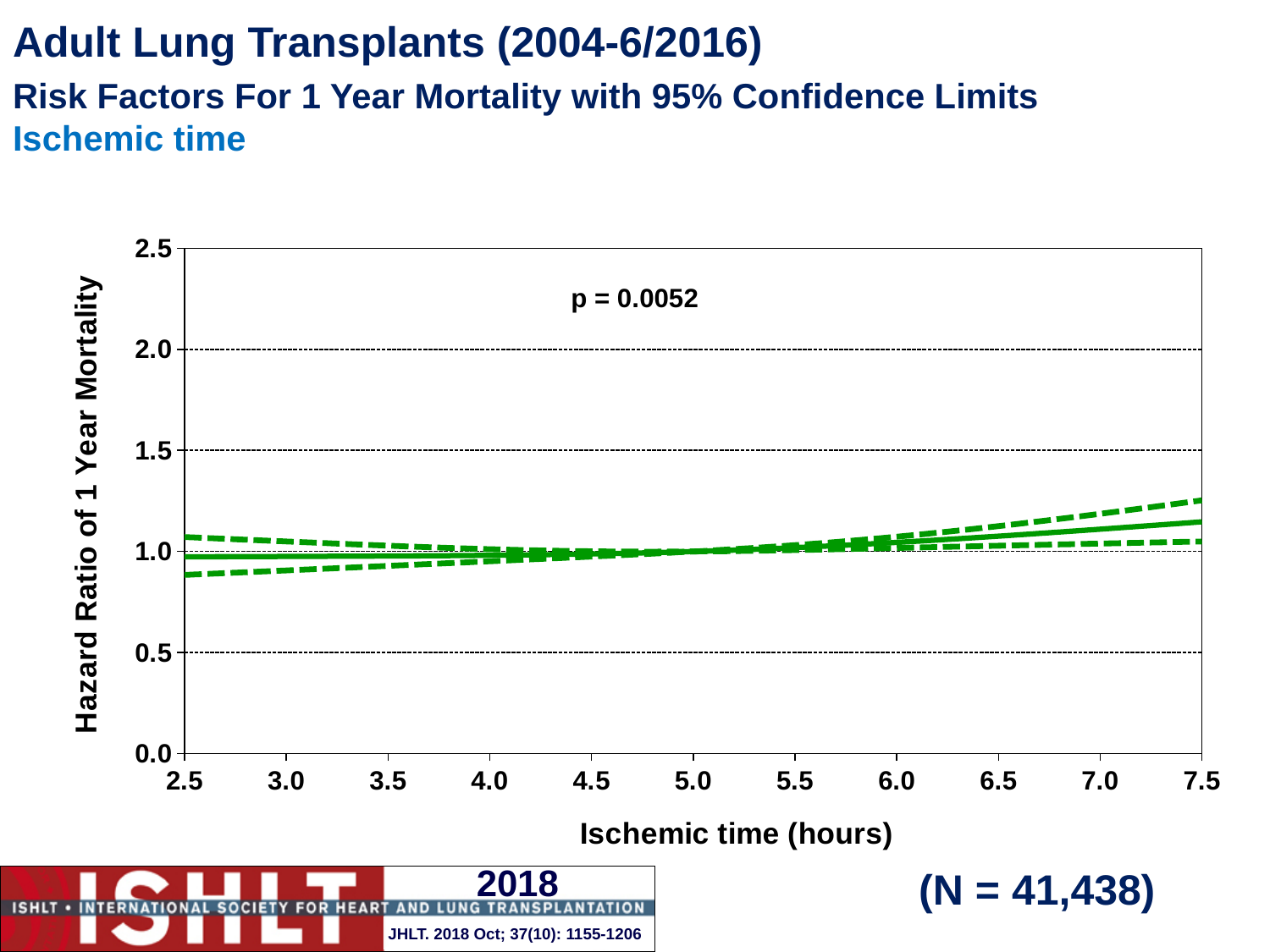
At which ischemic time shown on the x axis is the hazard ratio of 1 year mortality highest? 7.5 hours Is the hazard ratio of 1 year mortality at an ischemic time of 7.5 hours greater or less than 1.0? greater How many lines are plotted on the chart (the estimate plus its confidence limits)? 3 What kind of chart is shown on the slide? line chart Does the hazard ratio of 1 year mortality rise or fall as ischemic time increases from 5.0 to 7.5 hours? rise Is the lower 95% confidence limit at an ischemic time of 2.5 hours greater or less than 0.5? greater Is the hazard ratio at an ischemic time of 7.5 hours larger or smaller than the hazard ratio at 5.0 hours? larger Is the upper 95% confidence limit at an ischemic time of 7.5 hours greater or less than 1.5? less What p-value is printed on the chart? p = 0.0052 What sample size (N) is shown on the slide? N = 41,438